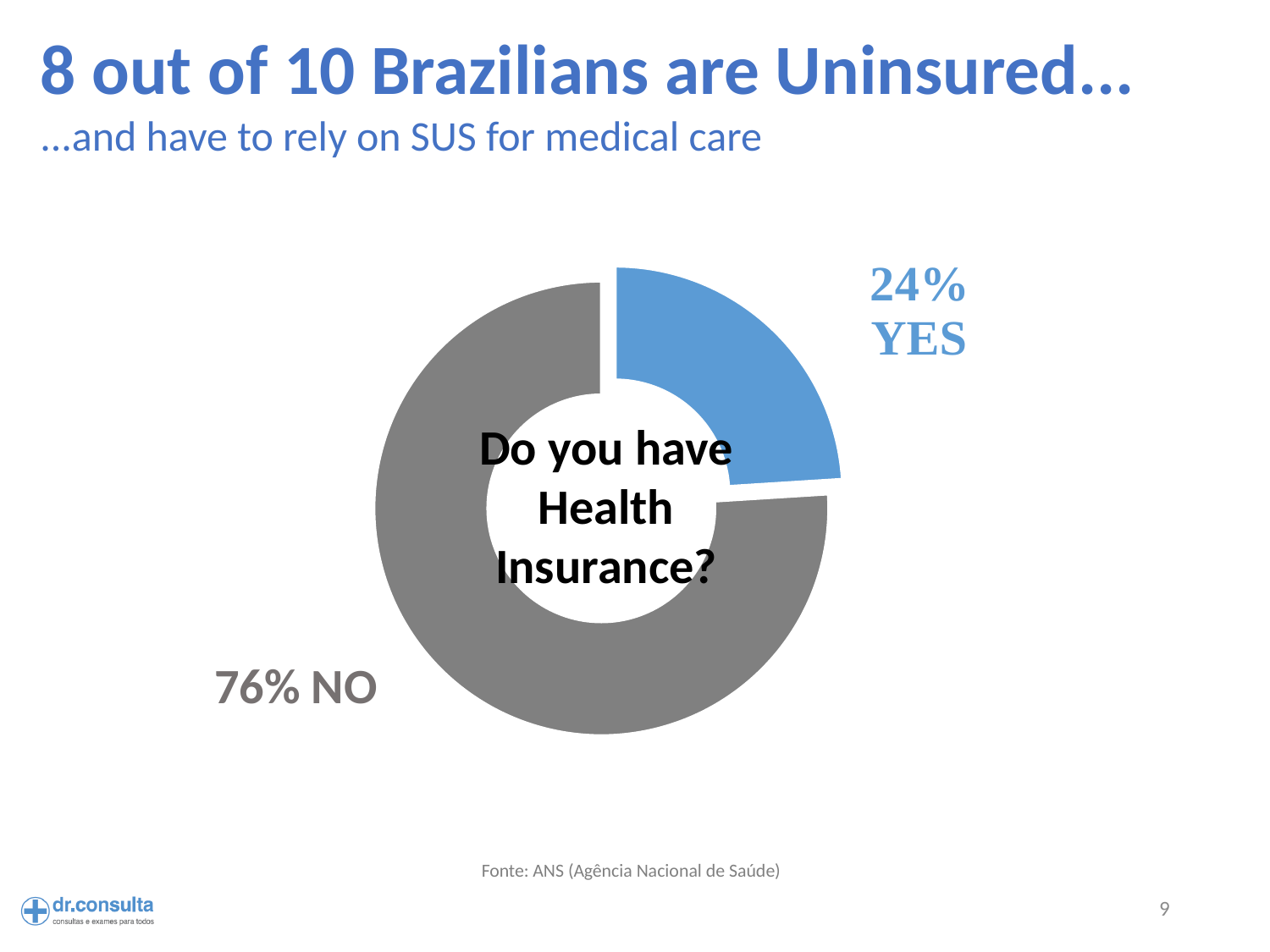
How many slices does the chart have? 2 Is the share for YES larger or smaller than the share for NO? smaller What share of the chart does the NO slice represent? 76% What percentage of respondents answered NO to having health insurance? 76% What percentage of respondents answered YES to having health insurance? 24% What kind of chart is shown on the slide? pie chart (doughnut) What colour is the YES slice of the chart? blue What question is written in the centre of the chart? Do you have Health Insurance? What is the difference in percentage points between the NO share and the YES share? 52 Which response has the larger share of the chart, YES or NO? NO Which response has the smaller share of the chart? YES